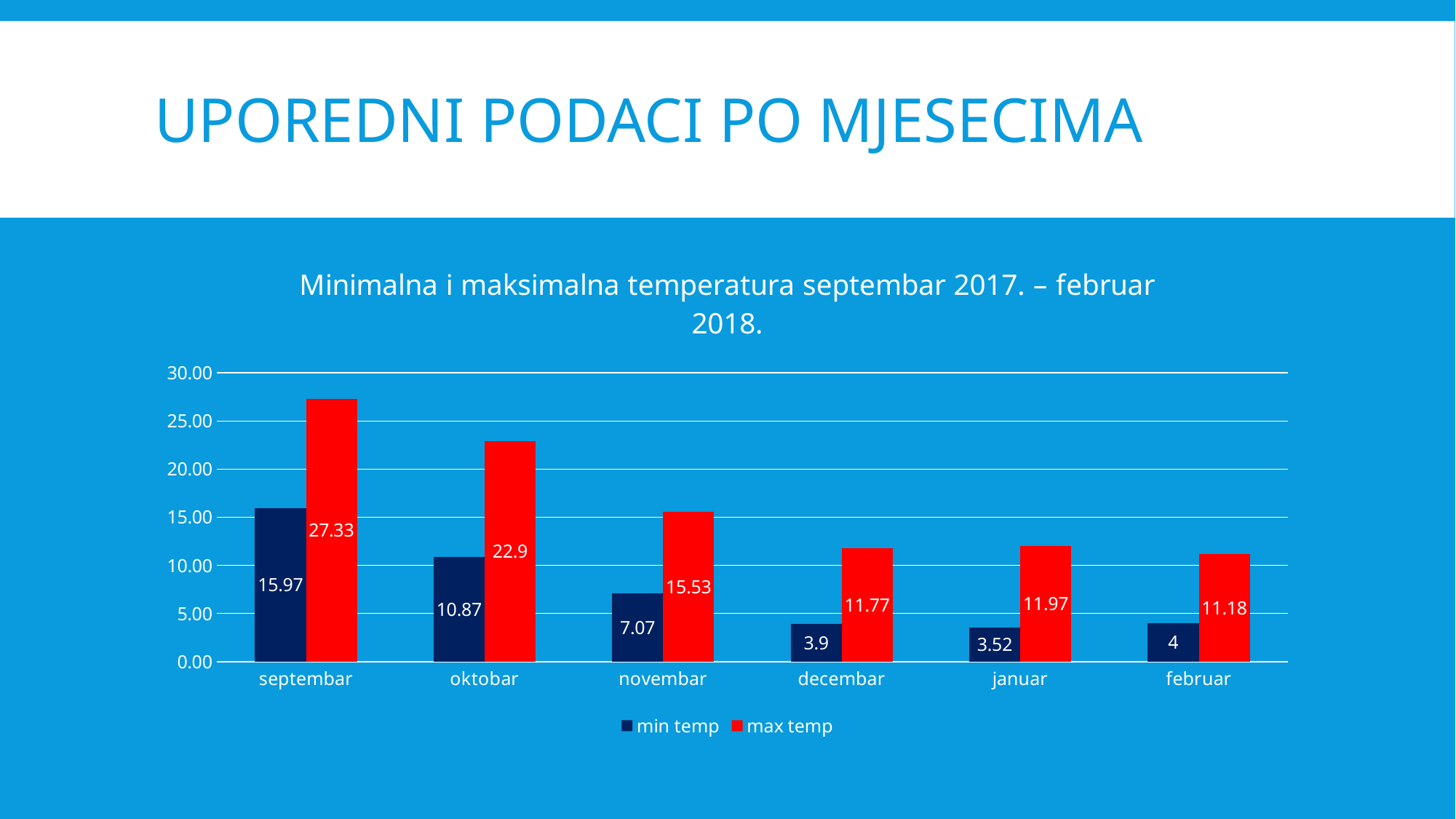
What kind of chart is shown on the slide? bar chart Which is larger, the max temp for decembar or the max temp for februar? decembar How many months are shown on the x axis? 6 How many series does the legend list? 2 What is the min temp value for septembar? 15.97 What is the title of the chart? Minimalna i maksimalna temperatura septembar 2017. – februar 2018. What is the max temp value for novembar? 15.53 Which month has the highest max temp? septembar Is the max temp value for septembar greater or less than 25.00? greater What is the max temp value for januar? 11.97 Which month has the lowest min temp? januar What is the difference between the max temp and min temp for oktobar? 12.03